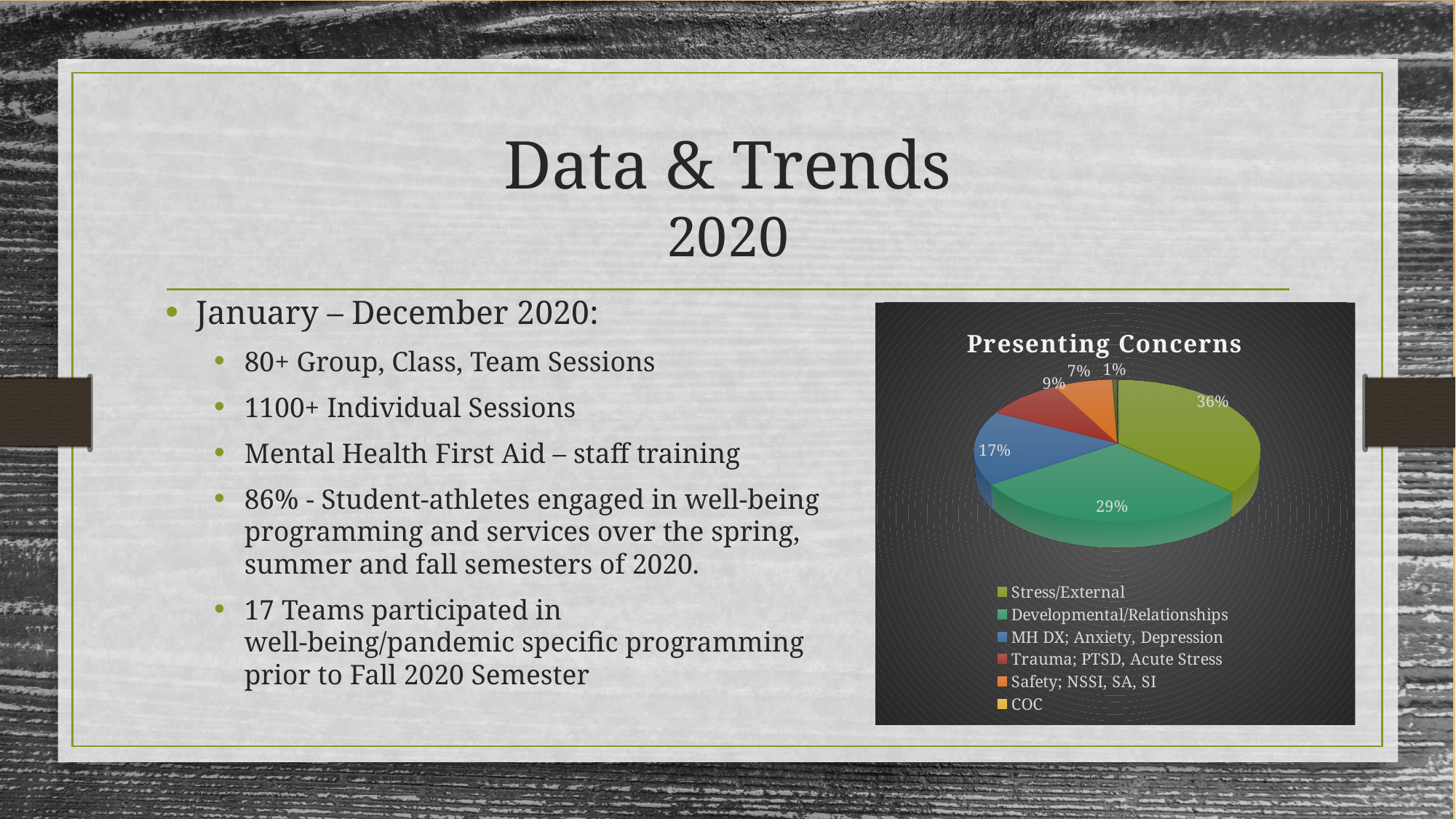
What is the difference between the Stress/External and Developmental/Relationships shares? 7% What is the value for Trauma; PTSD, Acute Stress? 9% What kind of chart is shown on the slide? pie chart Which is larger, the share for Trauma; PTSD, Acute Stress or the share for Safety; NSSI, SA, SI? Trauma; PTSD, Acute Stress What share of the pie does Developmental/Relationships take? 29% What is the value for MH DX; Anxiety, Depression? 17% How many categories does the legend list? 6 Which presenting concern has the largest slice? Stress/External What is the title of the chart? Presenting Concerns What is the value for Safety; NSSI, SA, SI? 7% What share of the pie does Stress/External take? 36%